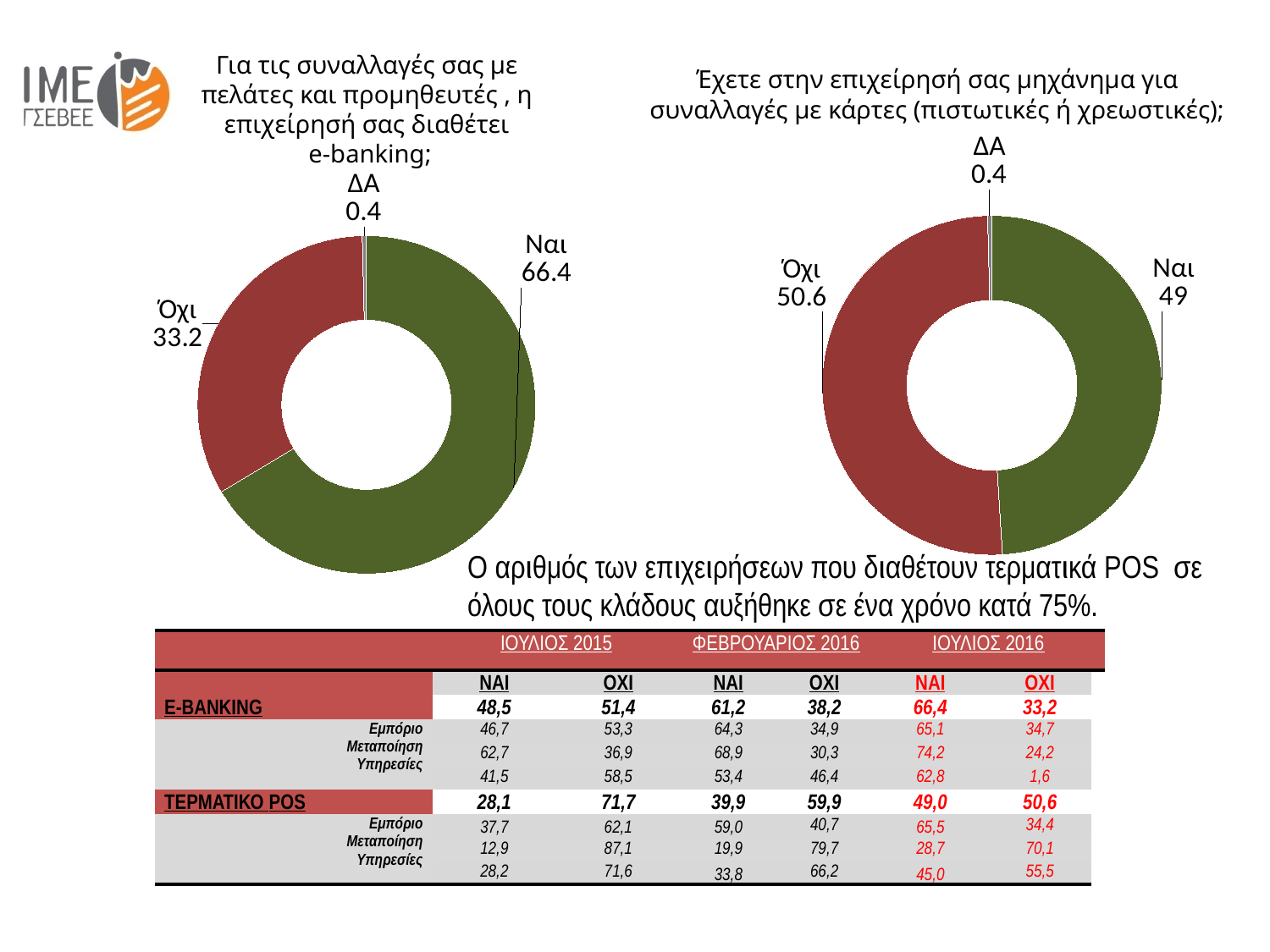
In the left doughnut chart about e-banking, what is the difference between the Ναι and Όχι values? 33.2 In the left doughnut chart about e-banking, what is the value for Όχι? 33.2 In the right doughnut chart about card transaction machines, which category has the smallest share? ΔΑ What type of chart is used on the right side of the slide for the card transaction machine question? Doughnut (pie) chart In the left doughnut chart about e-banking, what is the value for Ναι? 66.4 In the left doughnut chart about e-banking, which category has the largest share? Ναι In the left doughnut chart about e-banking, what is the value for ΔΑ? 0.4 In the right doughnut chart about card transaction machines, what is the value for Ναι? 49 In the right doughnut chart about card transaction machines, what is the value for Όχι? 50.6 In the right doughnut chart about card transaction machines, which is larger, Ναι or Όχι? Όχι How many categories does the left doughnut chart about e-banking show? 3 In the right doughnut chart about card transaction machines, what is the difference between the Όχι and Ναι values? 1.6